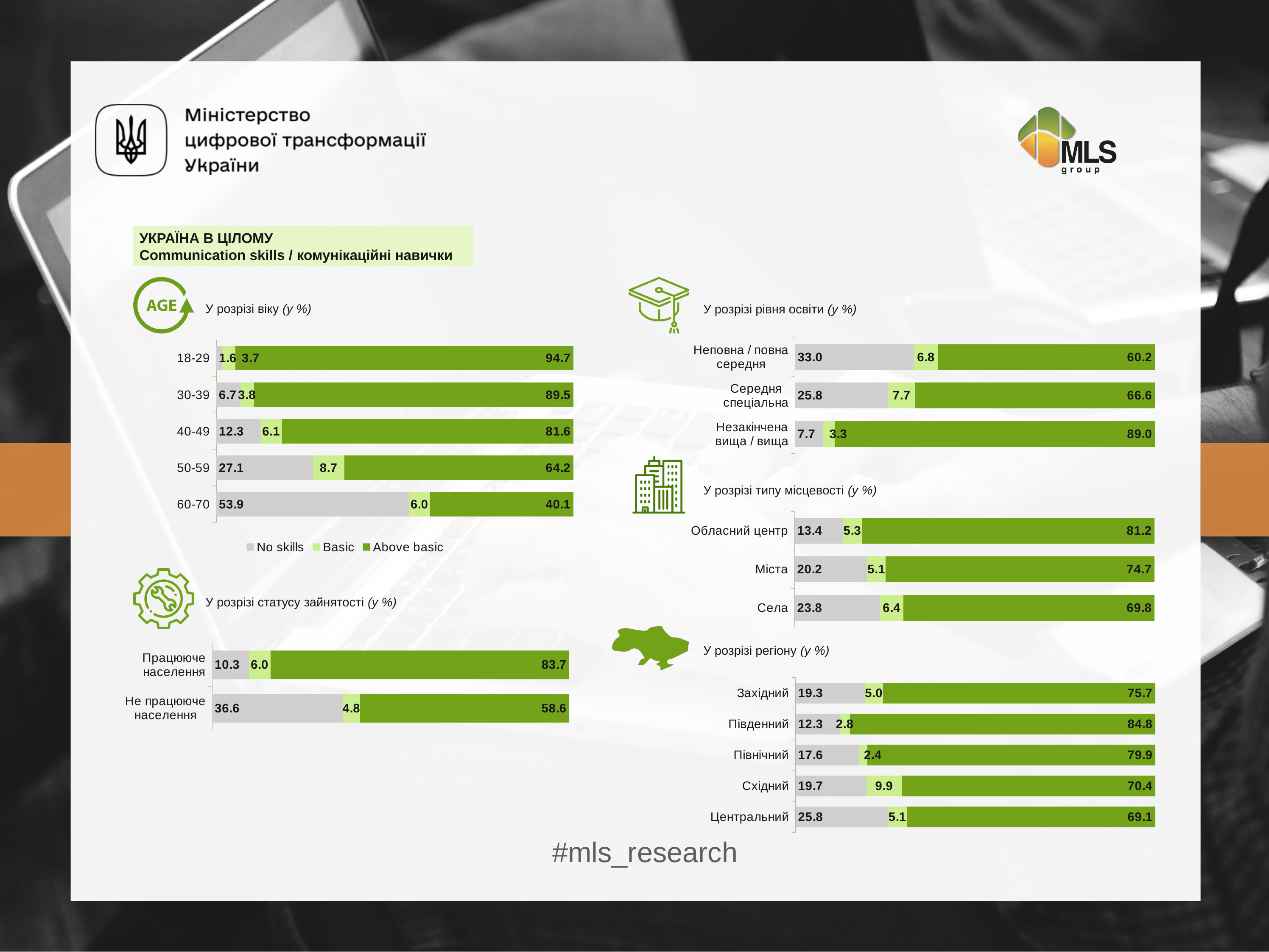
In the age chart (У розрізі віку), what is the Above basic value for the 18-29 group? 94.7 In the locality type chart (У розрізі типу місцевості), which has a larger Above basic value, Міста or Села? Міста In the age chart (У розрізі віку), how many age groups are shown? 5 What kind of chart is used for the region breakdown (У розрізі регіону)? Stacked bar chart In the age chart (У розрізі віку), how many series does the legend list? 3 In the region chart (У розрізі регіону), which region has the highest Above basic value? Південний In the education level chart (У розрізі рівня освіти), which category has the lowest No skills value? Незакінчена вища / вища In the age chart (У розрізі віку), which age group has the highest Above basic value? 18-29 In the age chart (У розрізі віку), what is the No skills value for the 60-70 group? 53.9 In the education level chart (У розрізі рівня освіти), what is the Basic value for Середня спеціальна? 7.7 In the region chart (У розрізі регіону), what is the Basic value for Східний? 9.9 In the employment status chart (У розрізі статусу зайнятості), what is the difference between the Above basic values for Працююче населення and Не працююче населення? 25.1